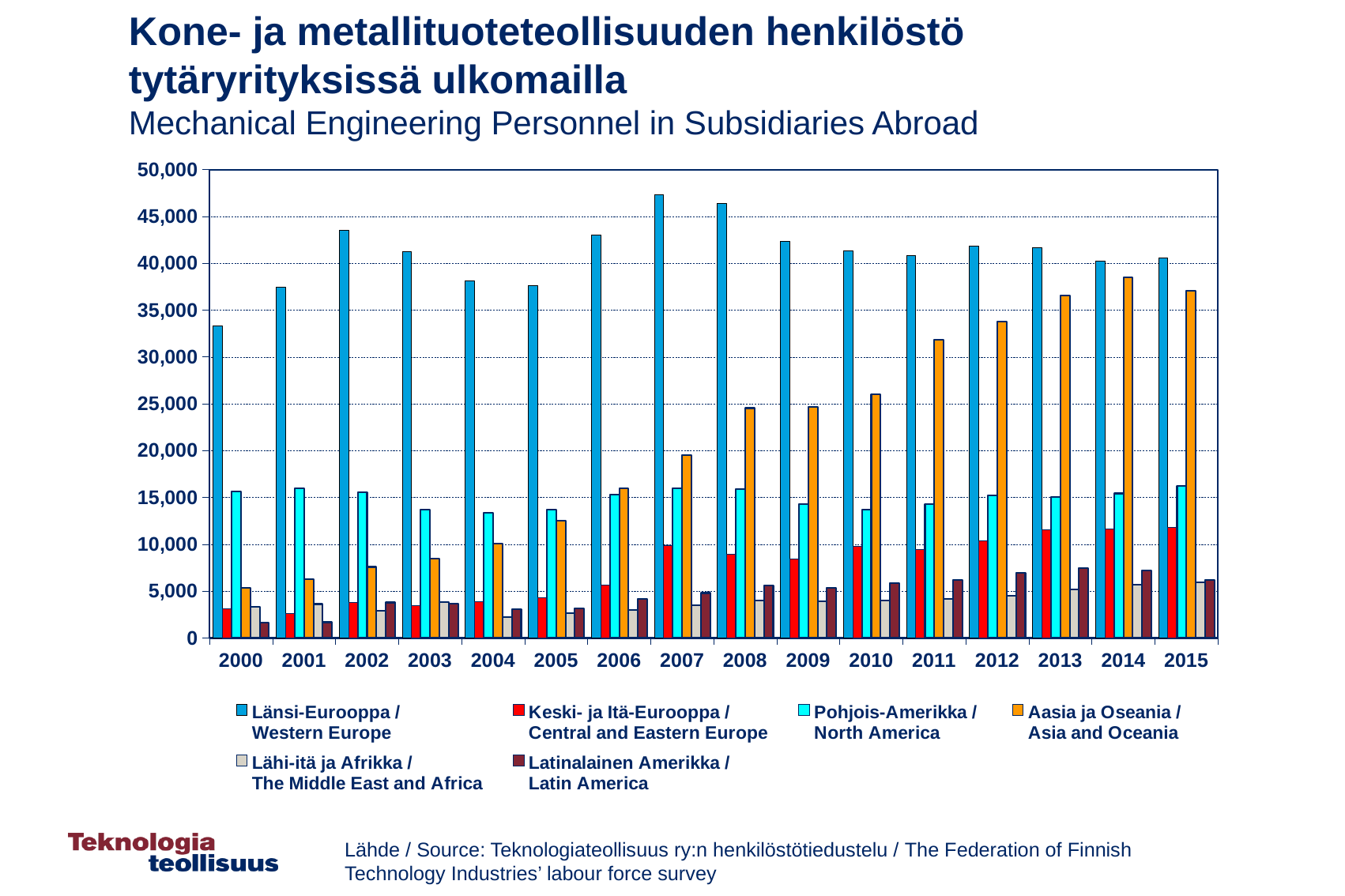
What kind of chart is shown on the slide? Bar chart What colour represents Asia and Oceania in the chart? Orange How many years are shown on the x axis? 16 How many series does the legend list? 6 Which is larger in 2013: Western Europe or Asia and Oceania? Western Europe In which year is the value for Asia and Oceania highest? 2014 Is the value for Asia and Oceania in 2015 greater or less than 35,000? greater Is the value for Asia and Oceania in 2000 greater or less than 10,000? less In which year is the value for Western Europe lowest? 2000 In which year is the value for Western Europe highest? 2007 Does the value for Asia and Oceania rise or fall from 2000 to 2014? rise Is the value for Western Europe in 2007 greater or less than 45,000? greater